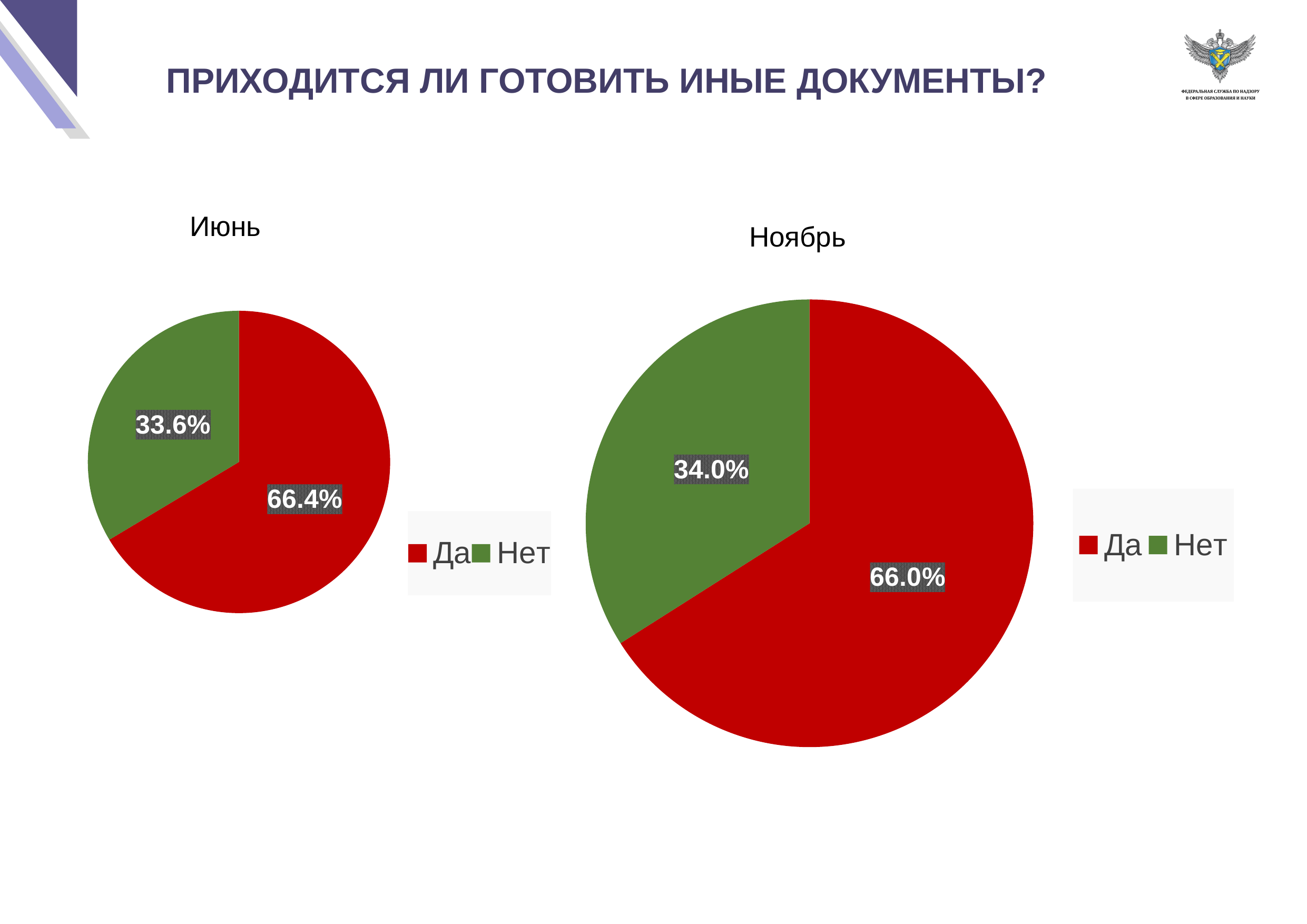
In the "Ноябрь" pie chart, what is the difference between the "Да" and "Нет" shares? 32.0% In the "Ноябрь" pie chart, what is the value for "Нет"? 34.0% In the "Июнь" pie chart, what is the difference between the "Да" and "Нет" shares? 32.8% How many categories does the "Июнь" pie chart show? 2 In the "Июнь" pie chart, what is the value for "Нет"? 33.6% In the "Июнь" pie chart, which category has the largest share? Да In the "Ноябрь" pie chart, what colour represents "Нет"? Green What type of chart is the "Ноябрь" chart? Pie chart Is the "Да" share larger in the "Июнь" chart or the "Ноябрь" chart? Июнь In the "Ноябрь" pie chart, what is the value for "Да"? 66.0% In the "Июнь" pie chart, what is the value for "Да"? 66.4% In the "Ноябрь" pie chart, which category has the smallest share? Нет